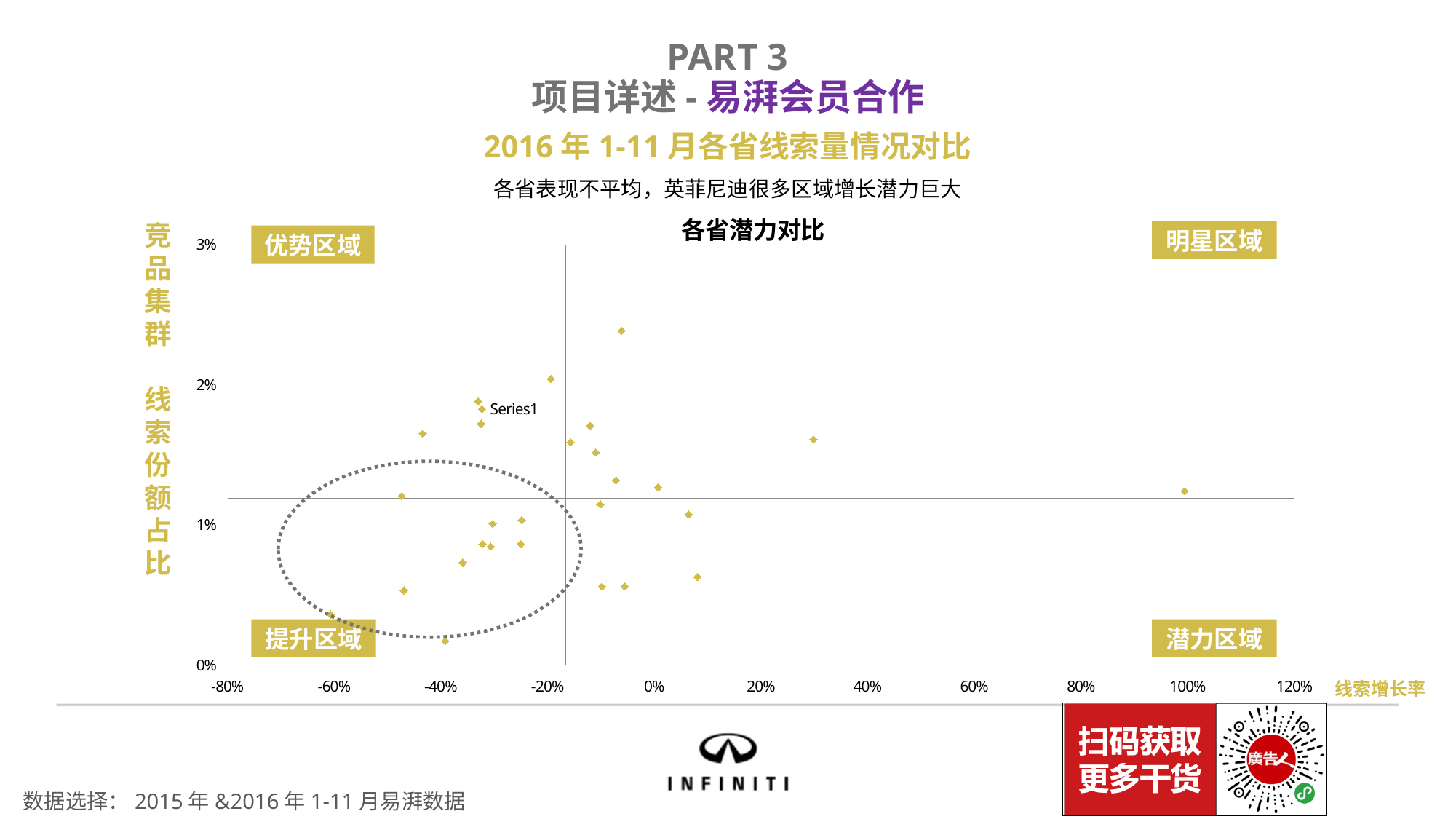
What label is shown at the right end of the x axis of the chart? 线索增长率 Is the y value of the point labeled Series1 greater or less than 1%? greater Is the y value of the highest point in the chart greater or less than 2%? greater Is the x value of the highest point in the chart greater or less than -20%? greater What kind of chart is shown on the slide? scatter chart What is the title of the chart? 各省潜力对比